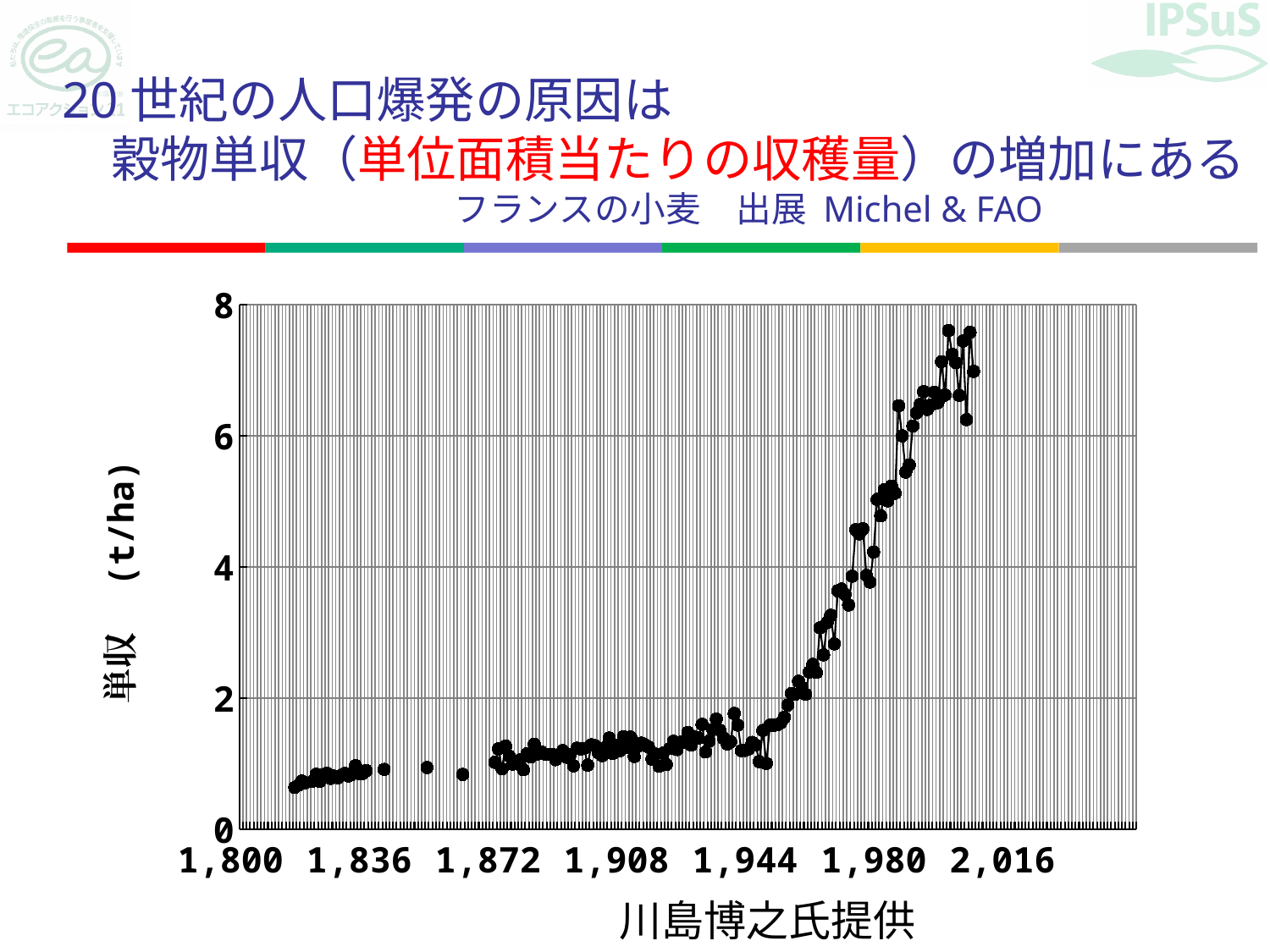
What is the first year label shown on the x axis? 1,800 Is the value for the year 1,980 greater or less than 4? greater Are the values around the year 2,016 greater or less than 6? greater Which is larger, the value around 1,980 or the value around 1,908? 1,980 Overall, do the plotted values rise or fall from left to right along the x axis? rise Is the value for the year 1,908 greater or less than 2? less What is the label of the y axis? 単収 (t/ha) What is the highest value shown on the y axis? 8 What kind of chart is shown on the slide? Scatter/line chart In which period are the plotted values highest: around 1,836 or around 2,016? around 2,016